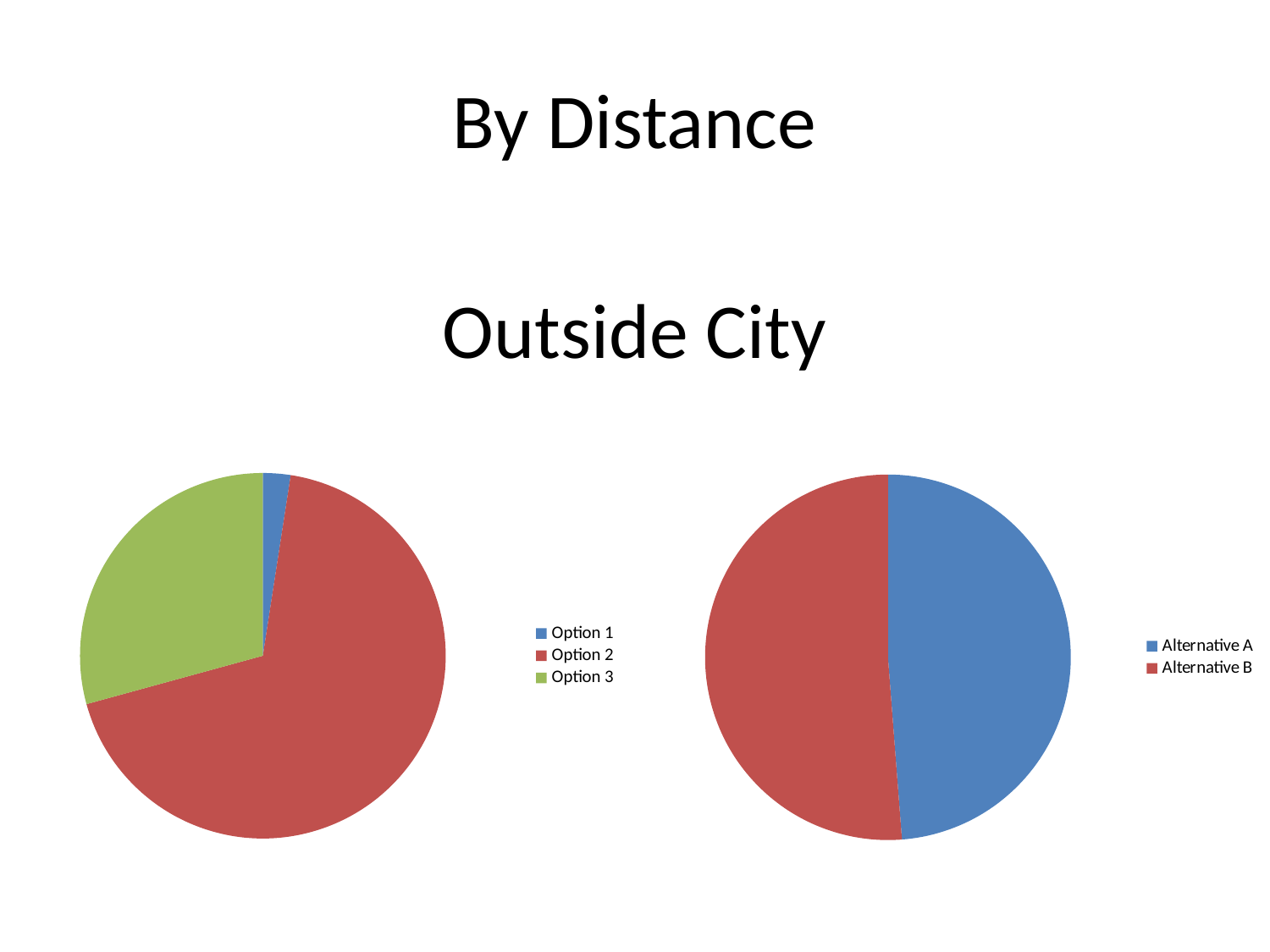
What kind of chart is the left chart on the slide? Pie chart In the left pie chart, which is larger, Option 2 or Option 3? Option 2 In the left pie chart, which category has the smallest slice? Option 1 In the left pie chart, which is larger, Option 1 or Option 3? Option 3 In the right pie chart, how many entries does the legend list? 2 In the right pie chart, how many slices are there? 2 In the left pie chart, which category has the largest slice? Option 2 In the left pie chart, how many entries does the legend list? 3 In the left pie chart, what colour is the Option 3 slice? Green What kind of chart is the right chart on the slide? Pie chart In the right pie chart, what are the two legend entries? Alternative A and Alternative B In the left pie chart, how many slices are there? 3